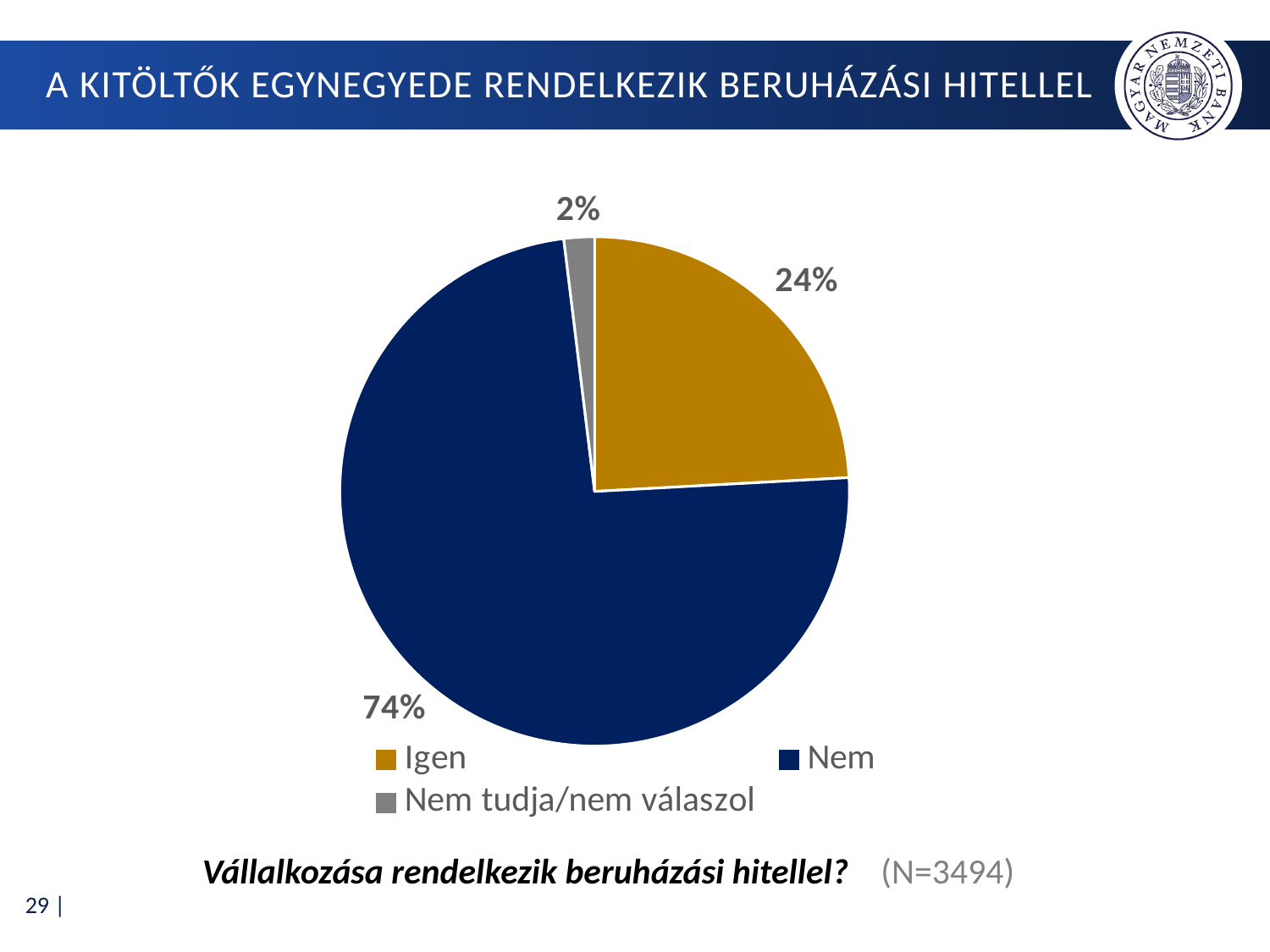
What colour is the "Nem" slice? dark blue What share of respondents answered "Igen"? 24% What is the sample size (N) stated below the chart? N=3494 How many categories does the pie chart show? 3 How many entries does the legend list? 3 Which category has the largest slice of the pie? Nem What kind of chart is shown on the slide? pie chart What is the difference in percentage points between the "Nem" and "Igen" slices? 50 percentage points Which is larger, the "Igen" slice or the "Nem tudja/nem válaszol" slice? Igen What share of respondents answered "Nem tudja/nem válaszol"? 2% Which category has the smallest slice of the pie? Nem tudja/nem válaszol What share of respondents answered "Nem"? 74%